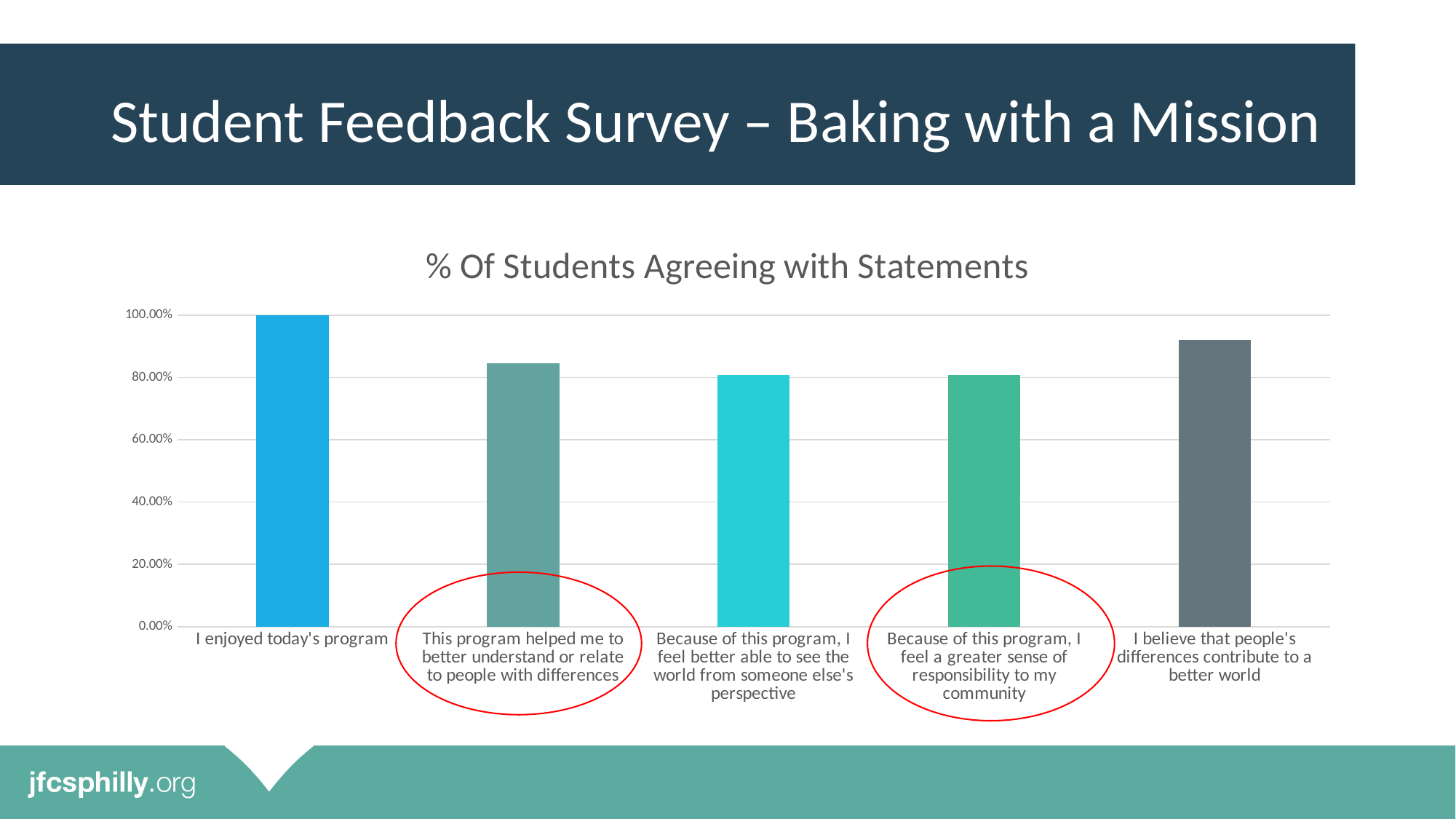
Is the value for "I believe that people's differences contribute to a better world" greater or less than 100.00%? less What kind of chart is shown on the slide? Bar chart What percentage of students agreed with the statement "I enjoyed today's program"? 100.00% How many statements (categories) are plotted in the chart? 5 What is the title of the chart? % Of Students Agreeing with Statements Which statement has the highest percentage of students agreeing? I enjoyed today's program How many category labels on the chart are circled in red? 2 Is the value for "This program helped me to better understand or relate to people with differences" greater or less than 80.00%? greater Is the value for "Because of this program, I feel better able to see the world from someone else's perspective" greater or less than 60.00%? greater Which is larger: the value for "I believe that people's differences contribute to a better world" or the value for "This program helped me to better understand or relate to people with differences"? I believe that people's differences contribute to a better world Which is larger: the value for "I enjoyed today's program" or the value for "Because of this program, I feel a greater sense of responsibility to my community"? I enjoyed today's program